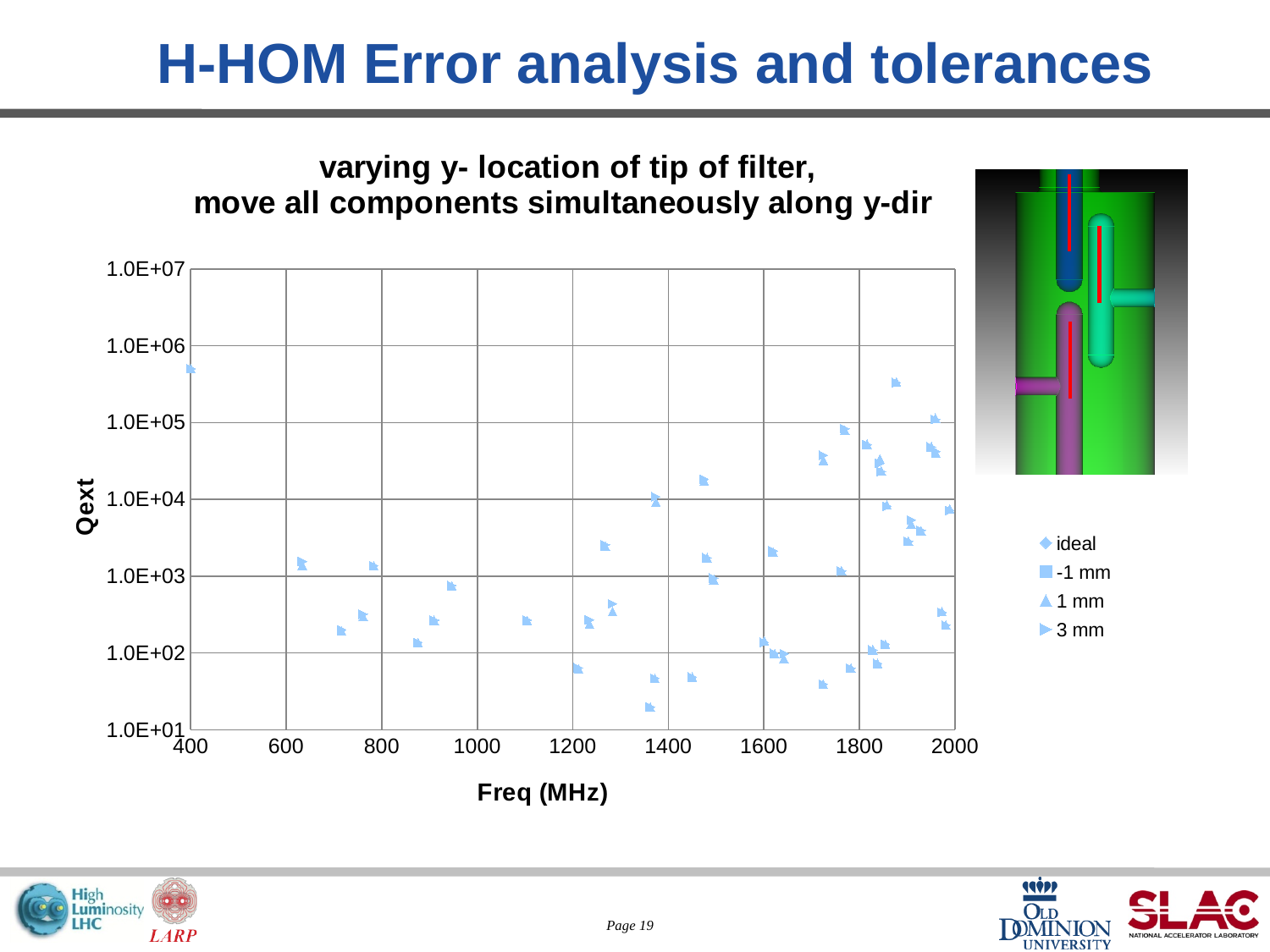
What kind of chart is shown on the slide? scatter chart What is the label of the x axis of the chart? Freq (MHz) Is the Qext value of the lowest plotted point (near 1370 MHz) greater or less than 1.0E+02? less What is the highest tick value shown on the y axis (Qext)? 1.0E+07 What are the series names listed in the chart legend? ideal, -1 mm, 1 mm, 3 mm Is the Qext value of the point plotted at about 400 MHz greater or less than 1.0E+05? greater How many series does the chart legend list? 4 Is the Qext value of the point plotted near 1100 MHz greater or less than 1.0E+03? less What is the lowest tick value shown on the y axis (Qext)? 1.0E+01 What is the highest frequency value shown on the x axis? 2000